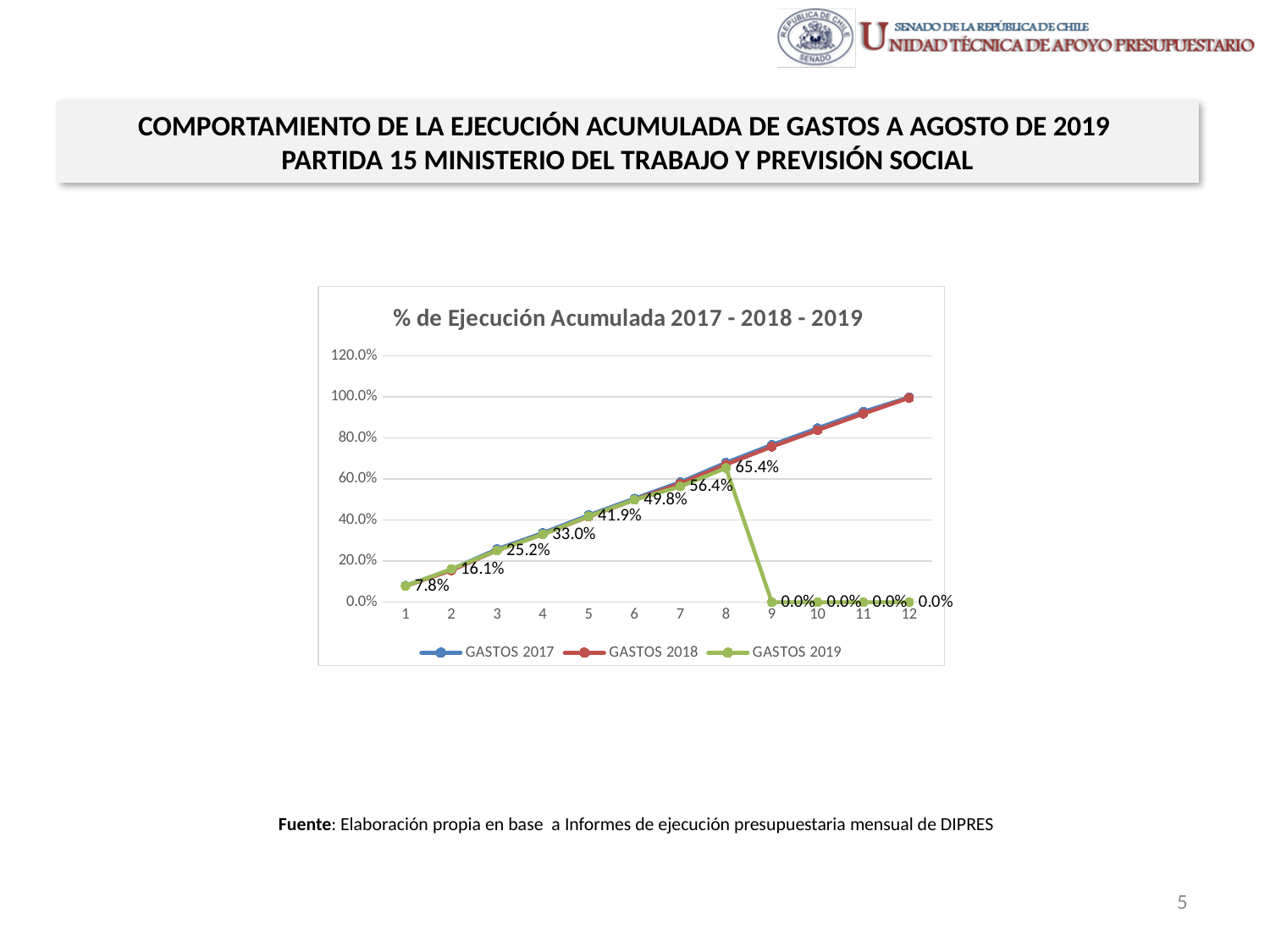
What is the value for GASTOS 2019 at point 4? 33.0% What is the value for GASTOS 2019 at point 1? 7.8% At which x-axis point does GASTOS 2019 reach its highest value? 8 Is the value for GASTOS 2017 at point 12 greater or less than 80.0%? greater What is the difference between the GASTOS 2019 values at point 8 and point 7? 9.0% What is the title of the chart? % de Ejecución Acumulada 2017 - 2018 - 2019 How many series does the legend list? 3 Do the GASTOS 2019 values rise or fall from point 1 to point 8? rise What is the value for GASTOS 2019 at point 8? 65.4% How many points are on the x axis of the chart? 12 What is the value for GASTOS 2019 at point 10? 0.0% What type of chart is shown on the slide? Line chart